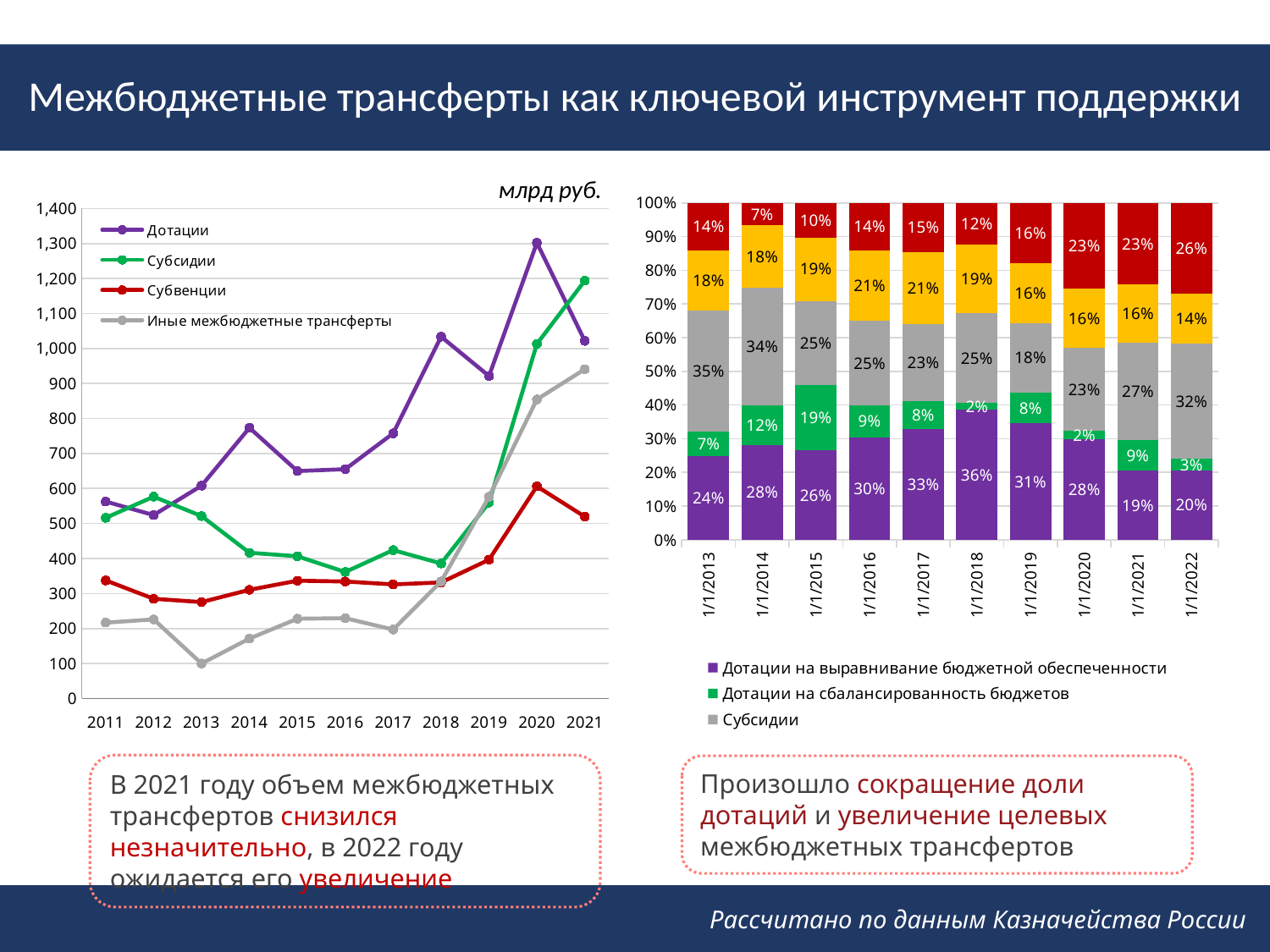
What kind of chart is the chart on the left of the slide? line chart In the left chart, is the value for Дотации in 2020 greater or less than 1,200? greater In the right chart, in which year is the share of Дотации на выравнивание бюджетной обеспеченности lowest? 1/1/2021 In the right chart, by how many percentage points does the top (red) segment on 1/1/2022 exceed the top (red) segment on 1/1/2013? 12 percentage points In the right chart, what is the share of Субсидии on 1/1/2022? 32% In the right chart, what is the share of Дотации на выравнивание бюджетной обеспеченности on 1/1/2022? 20% In the left chart, is the value for Субсидии in 2021 greater or less than 1,100? greater In the right chart, in which year is the share of Дотации на выравнивание бюджетной обеспеченности highest? 1/1/2018 How many series does the legend of the left chart list? 4 In the left chart, is the value for Субвенции in 2013 greater or less than 300? less What kind of chart is the chart on the right of the slide? stacked bar chart How many years are plotted on the x axis of the left chart? 11